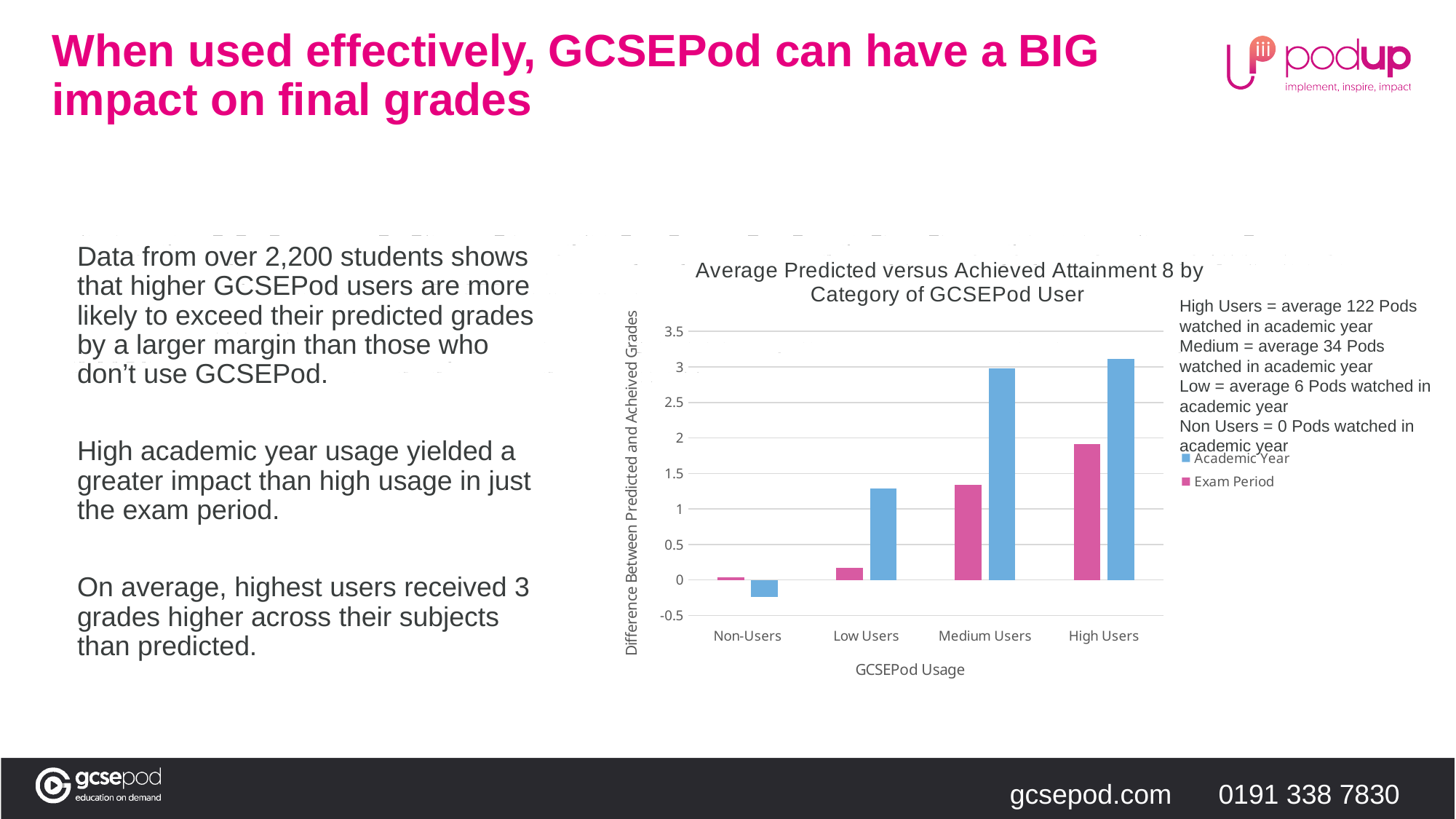
Which category has the lowest Academic Year value? Non-Users Which category has the highest Exam Period value? High Users Is the Exam Period value for High Users greater or less than 1.5? greater Is the Academic Year value for Non-Users greater or less than 0? less Is the Academic Year value for Low Users greater or less than 1? greater Do the Academic Year values rise or fall from Non-Users to High Users? rise How many categories of GCSEPod usage are shown on the x axis? 4 What kind of chart is shown on the slide? bar chart How many series does the chart legend list? 2 For Medium Users, which is larger: the Academic Year value or the Exam Period value? Academic Year What is the label on the chart's x axis? GCSEPod Usage